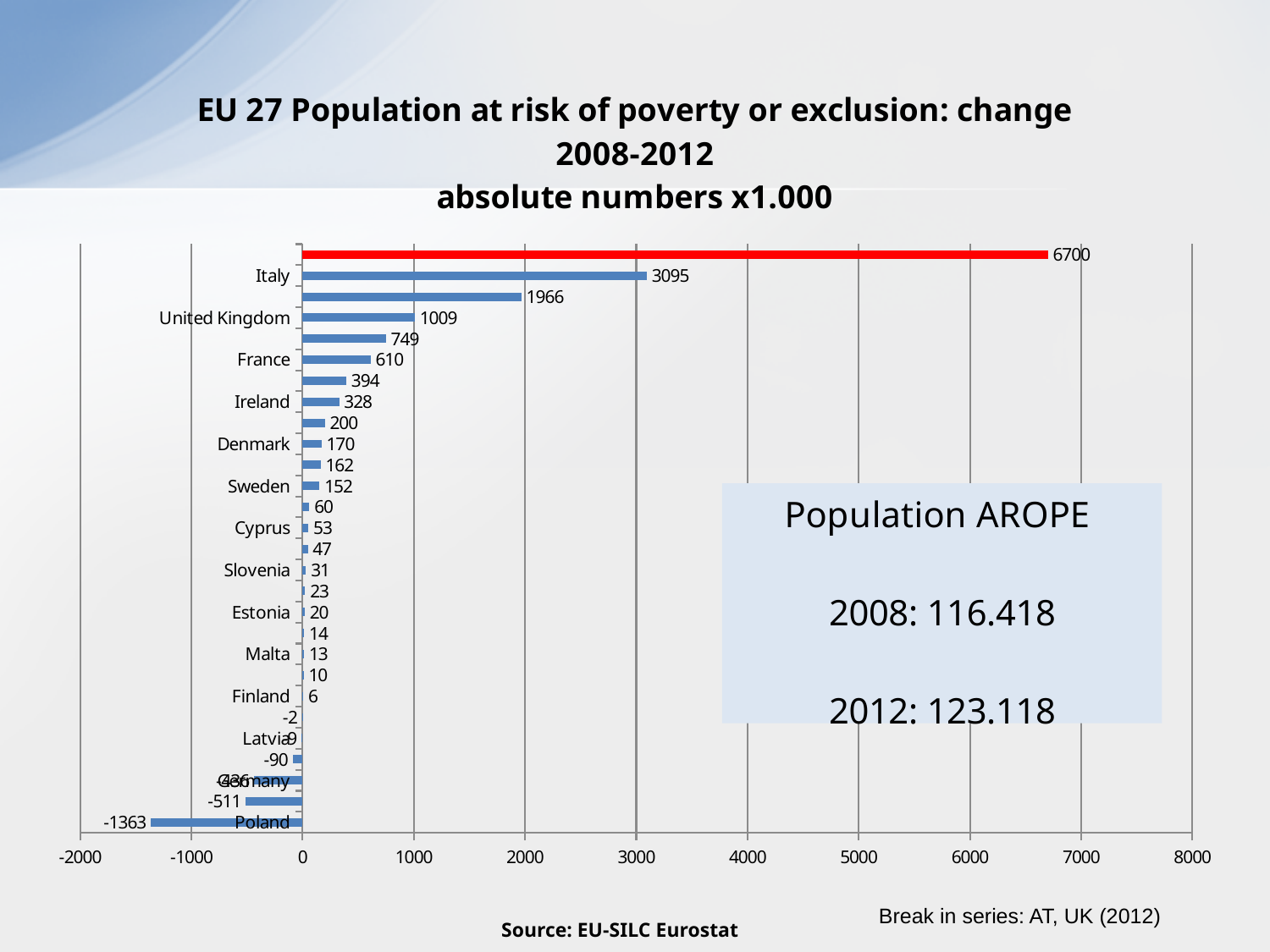
What is the value shown on the red bar at the top of the chart? 6700 What kind of chart is shown on the slide? bar chart What is the difference between the values for Denmark and Sweden? 18 What is the value for the United Kingdom? 1009 What is the data source stated below the chart? EU-SILC Eurostat Which labelled country has the lowest value? Poland What is the value for Denmark? 170 What is the value for France? 610 Which has the larger value, France or Ireland? France What is the difference between the values for Italy and the United Kingdom? 2086 What is the value for Italy? 3095 What is the value for Poland? -1363